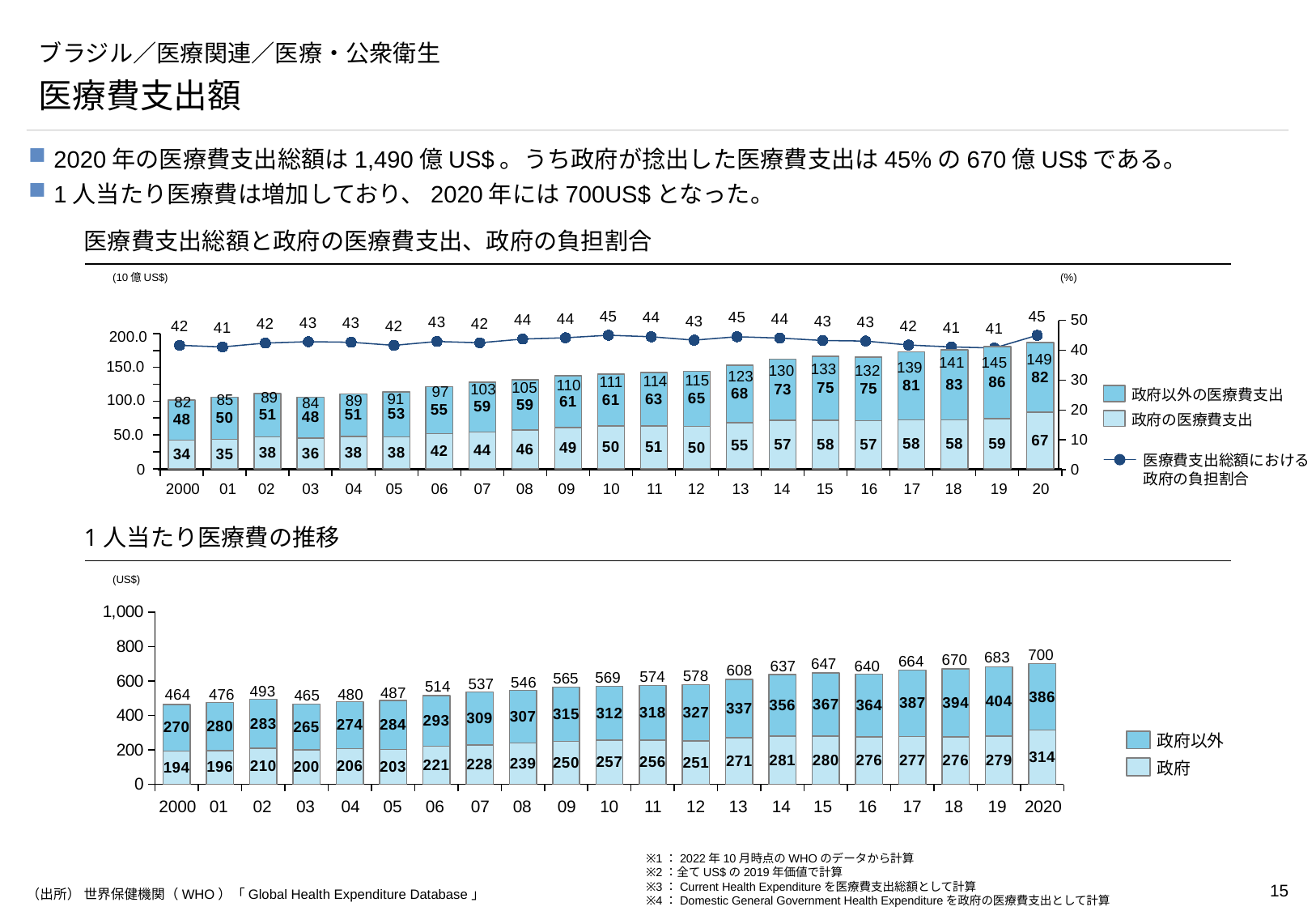
In the top chart, which year has the lowest total health expenditure? 2000 In the top chart, what is the difference between non-government (政府以外の医療費支出) and government (政府の医療費支出) health expenditure in 2020? 15 In the bottom chart (1人当たり医療費の推移), what is the per-capita health expenditure total for 2020? 700 In the top chart, what is the government's share of total health expenditure (line value) in 2010? 45 In the top chart (医療費支出総額と政府の医療費支出、政府の負担割合), what is the total health expenditure (bar total) for 2020? 149 In the top chart, what is the government health expenditure (政府の医療費支出) for 2000? 34 In the bottom chart, which year has the highest per-capita health expenditure? 2020 How many years are plotted on the x axis of the bottom chart? 21 How many series does the legend of the top chart list? 3 In the bottom chart, what is the government (政府) per-capita health expenditure for 2000? 194 In the bottom chart, is the per-capita health expenditure total for 2020 larger for 政府 or 政府以外? 政府以外 In the bottom chart, what is the difference between the per-capita totals for 2020 and 2019? 17